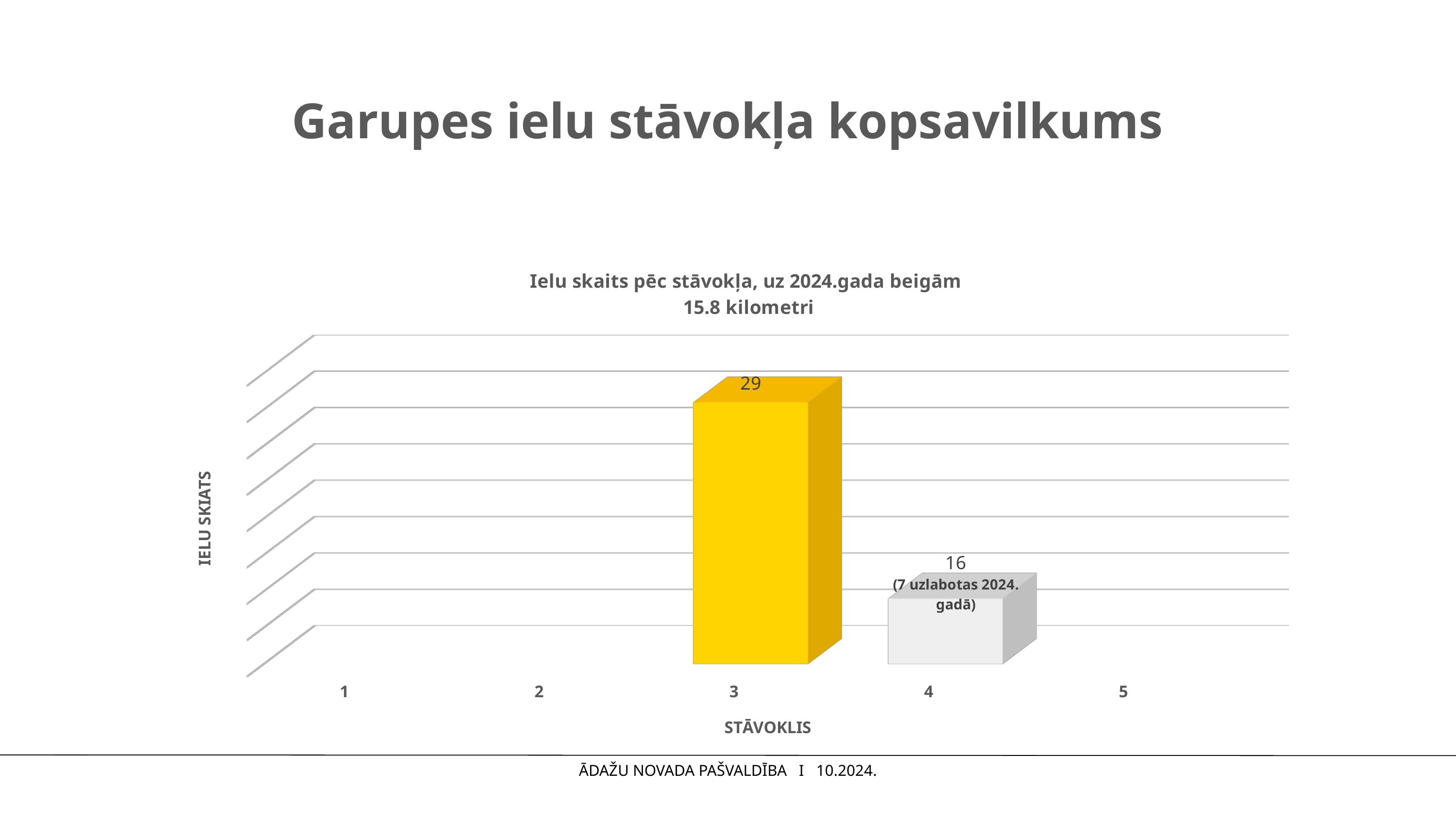
What kind of chart is shown? bar chart What is the label of the x axis? STĀVOKLIS What is the difference between the values for category 3 and category 4? 13 What is the value for category 4? 16 What is the title of the chart? Ielu skaits pēc stāvokļa, uz 2024.gada beigām 15.8 kilometri Which category has the highest value? 3 What is the value for category 3? 29 How many categories are labelled on the x axis? 5 Which is larger, the value for category 3 or the value for category 4? category 3